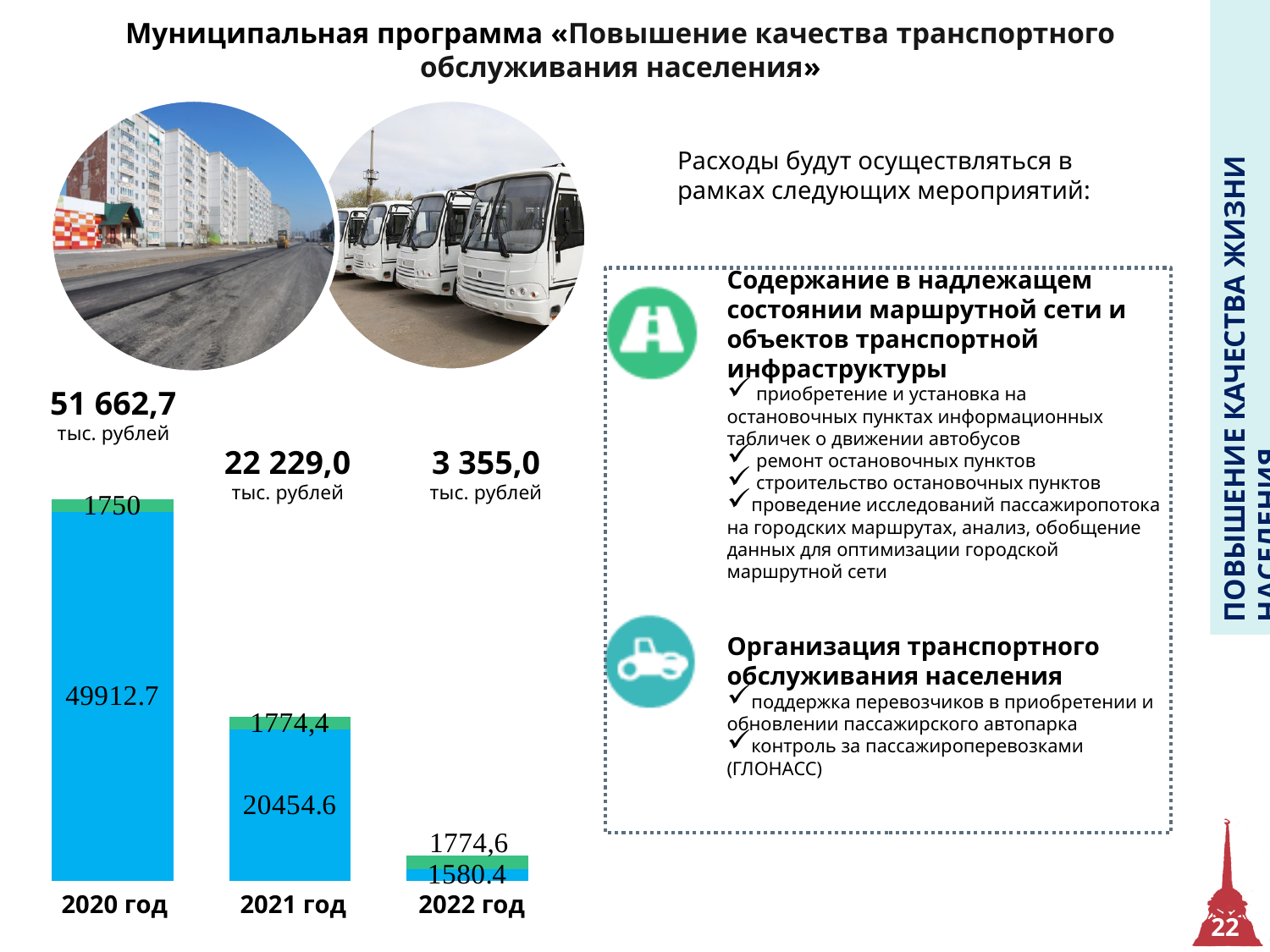
What is the value of the blue segment for 2020 год? 49912.7 What is the value of the green segment for 2021 год? 1774,4 What is the total shown above the bar for 2020 год? 51 662,7 тыс. рублей What is the total shown above the bar for 2022 год? 3 355,0 тыс. рублей Which year has the lowest total bar? 2022 год What is the value of the blue segment for 2021 год? 20454.6 How many years (categories) are shown on the bar chart? 3 What kind of chart is shown on the slide? bar chart What is the value of the blue segment for 2022 год? 1580.4 Do the total values rise or fall from 2020 год to 2022 год? fall Which year has the highest total bar? 2020 год What is the value of the green segment for 2020 год? 1750